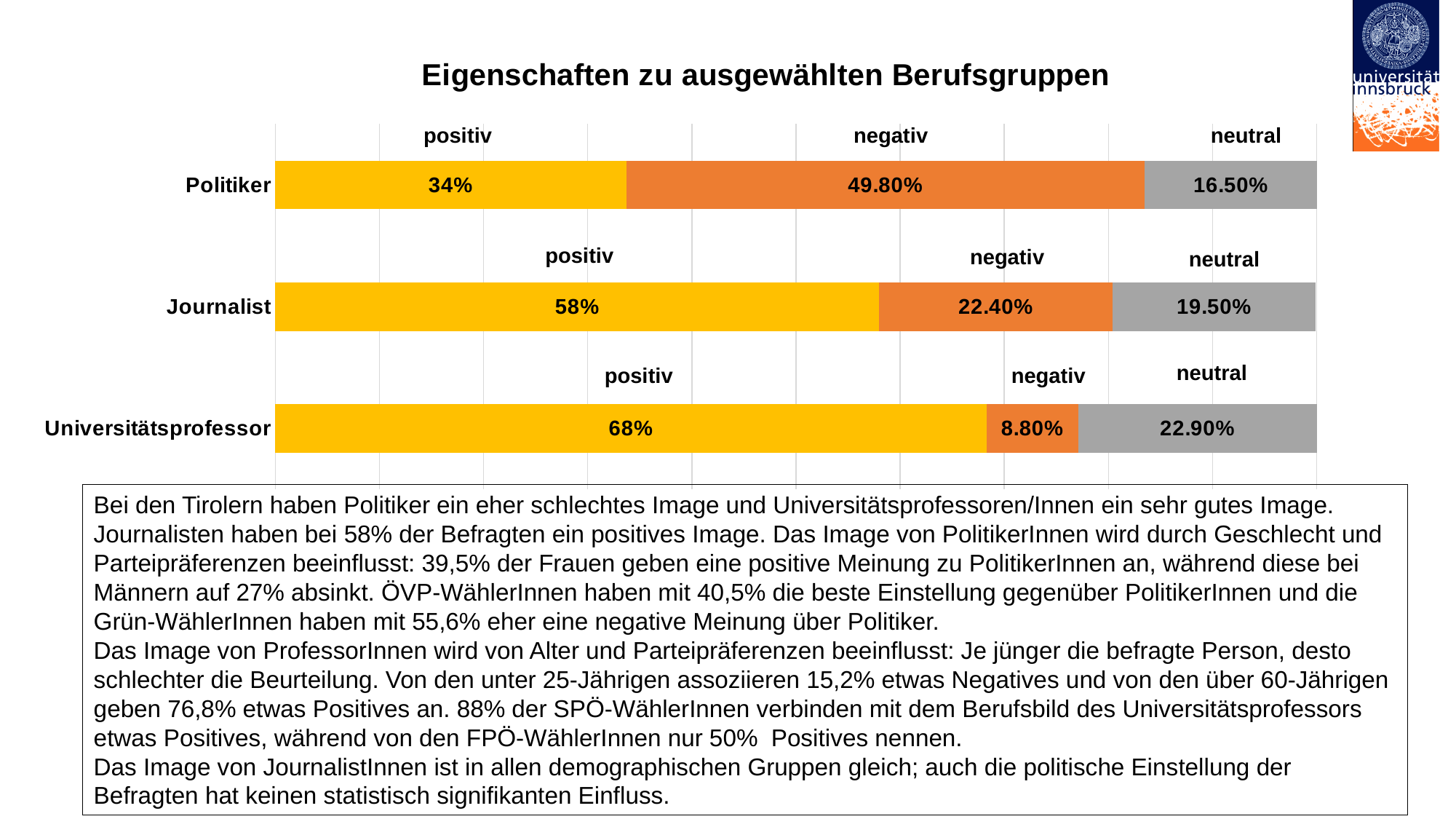
How many series (positiv, negativ, neutral) are shown for each bar? 3 What is the negative (negativ) value for Journalist? 22.40% How many occupational groups are shown in the chart? 3 What is the title of the chart? Eigenschaften zu ausgewählten Berufsgruppen What is the neutral value for Universitätsprofessor? 22.90% What is the negative (negativ) value for Universitätsprofessor? 8.80% What is the positive (positiv) value for Politiker? 34% Which occupational group has the highest positive (positiv) value? Universitätsprofessor What is the difference between the negative (negativ) values for Politiker and Journalist? 27.40% Which occupational group has the lowest negative (negativ) value? Universitätsprofessor What type of chart is shown on the slide? Stacked bar chart Which is larger: the neutral value for Journalist or the neutral value for Politiker? Journalist